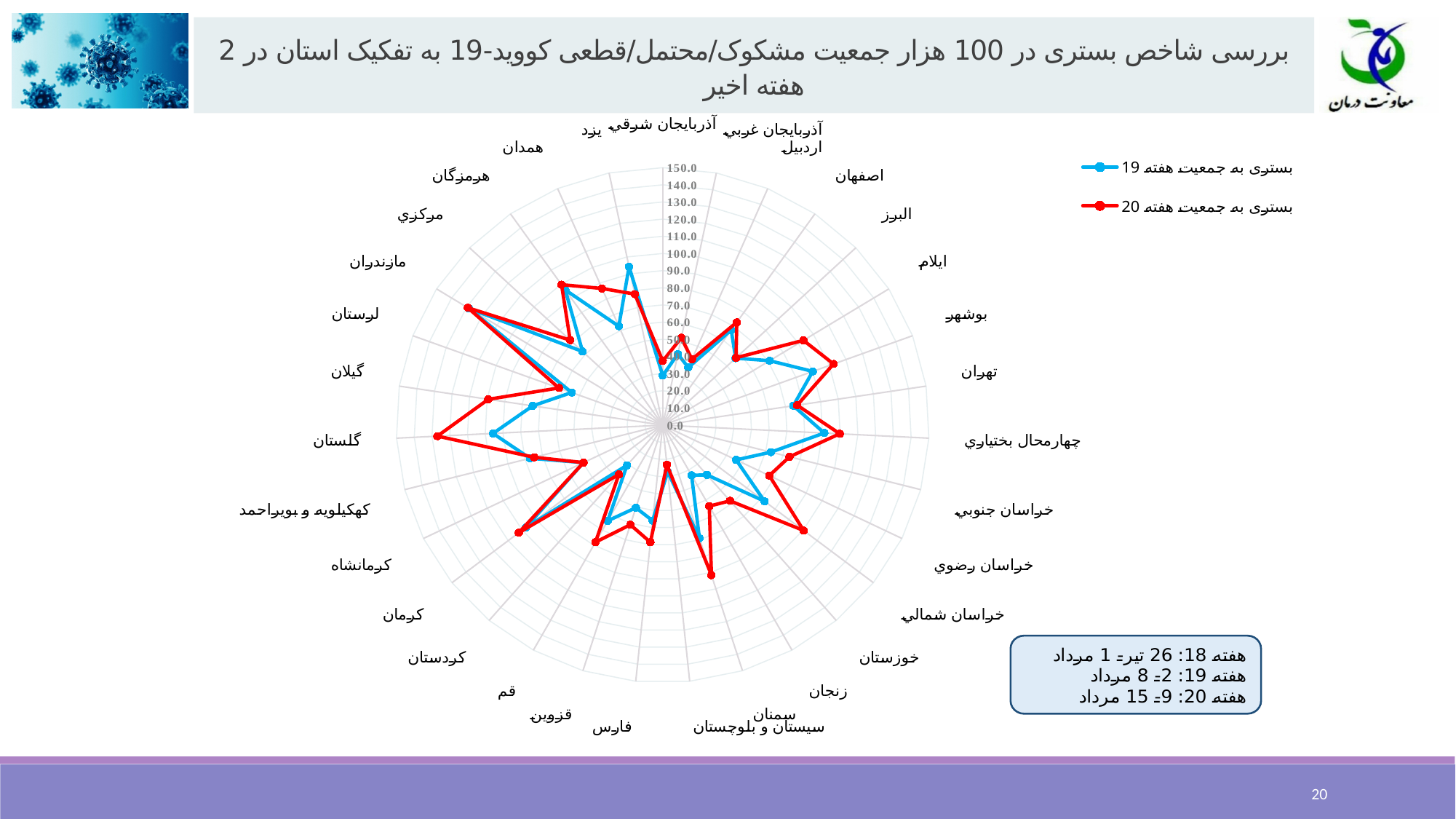
Is the value for كرمانشاه in the series بستری به جمعیت هفته 20 greater or less than 80? less Which series is drawn in red according to the legend? بستری به جمعیت هفته 20 Is the value for اردبيل in the series بستری به جمعیت هفته 19 greater or less than 60? less How many series does the legend list? 2 Which series is drawn in blue according to the legend? بستری به جمعیت هفته 19 What kind of chart is shown on the slide? Radar chart Is the value for گلستان in the series بستری به جمعیت هفته 20 greater or less than 100? greater For گلستان, which series has the larger value: بستری به جمعیت هفته 19 or بستری به جمعیت هفته 20? بستری به جمعیت هفته 20 How many provinces (categories) are plotted around the radar chart? 31